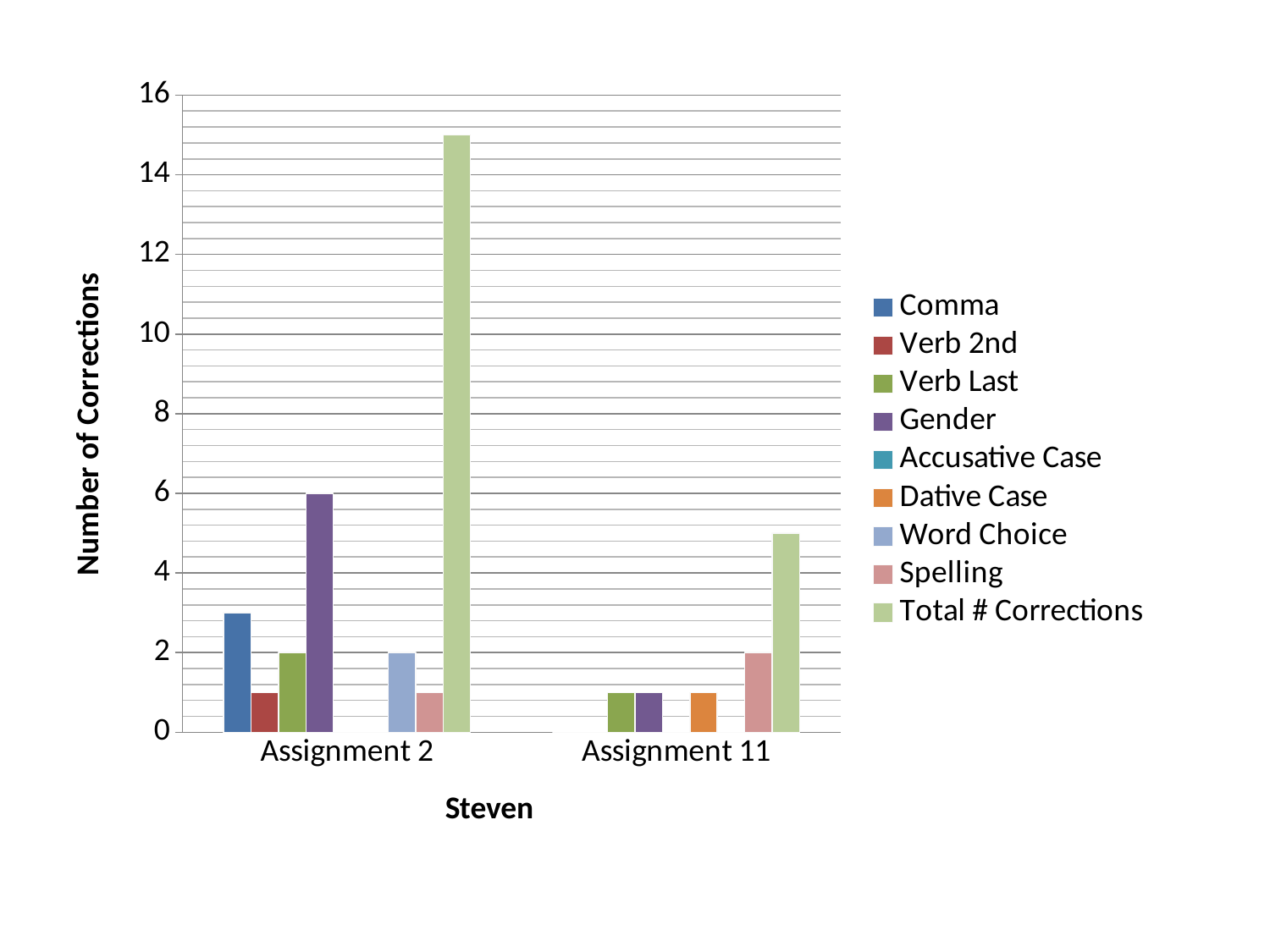
What kind of chart is shown on the slide? bar chart Is the value for Total # Corrections in Assignment 2 greater or less than 14? greater Which series has the highest value in Assignment 2? Total # Corrections What is the value for Gender in Assignment 2? 6 What is the value for Spelling in Assignment 11? 2 Is the value for Comma in Assignment 2 greater or less than 4? less Is the value for Total # Corrections in Assignment 11 greater or less than 4? greater How many assignment categories are shown on the x axis? 2 Which is larger, Total # Corrections in Assignment 2 or Total # Corrections in Assignment 11? Assignment 2 How many series does the legend list? 9 What is the label of the y axis? Number of Corrections What is the value for Word Choice in Assignment 2? 2